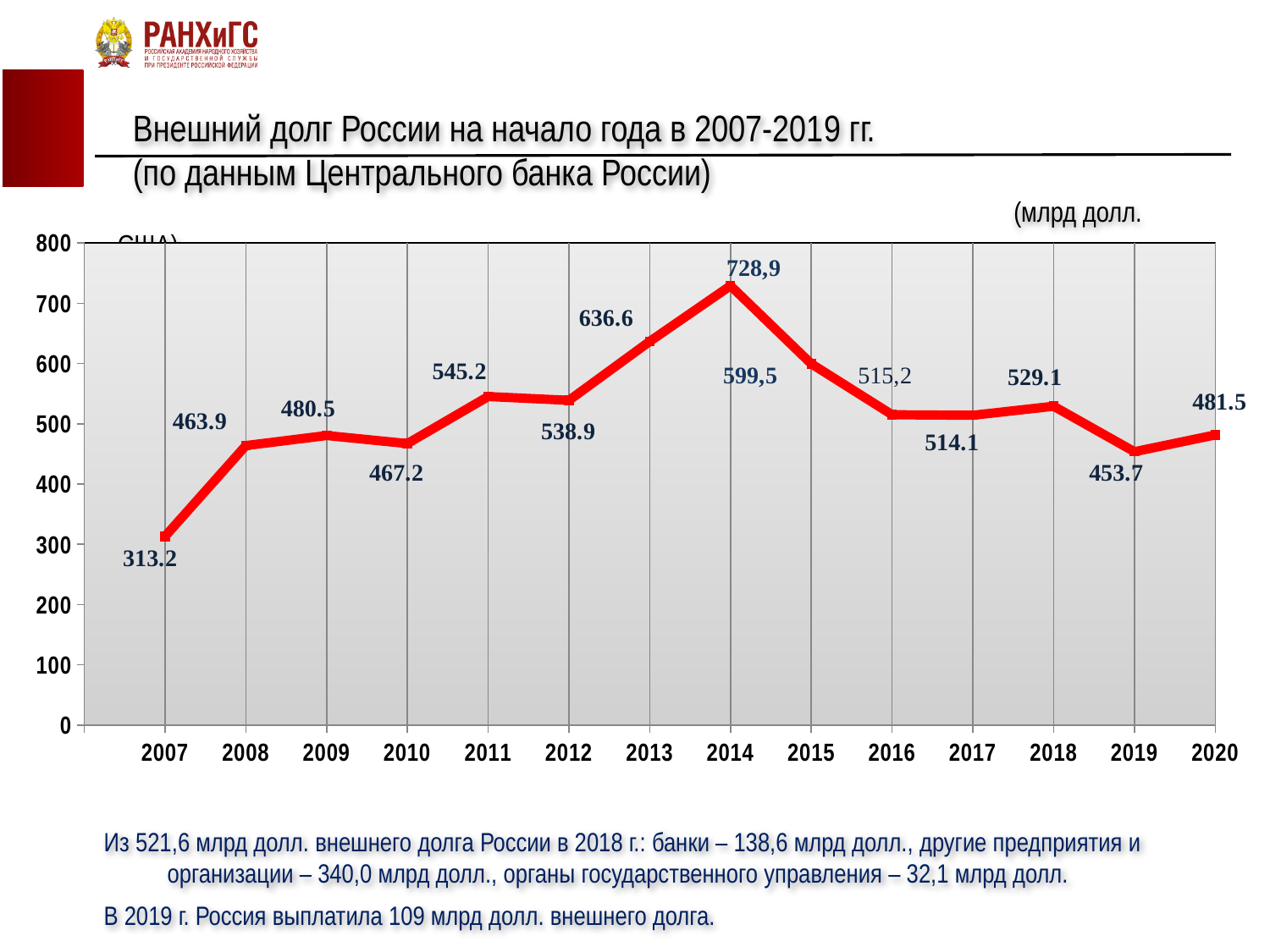
What is the difference between the values for 2014 and 2013? 92.3 What is the value for 2013? 636.6 Which year has the highest value? 2014 How many years are plotted on the x axis? 14 What is the value for 2019? 453.7 What is the value for 2014? 728,9 What is the value for 2007? 313.2 What type of chart is shown on the slide? line chart Which is larger, the value for 2011 or the value for 2012? 2011 Which year has the lowest value? 2007 Do the values rise or fall from 2014 to 2017? fall Is the value for 2015 greater or less than 500? greater